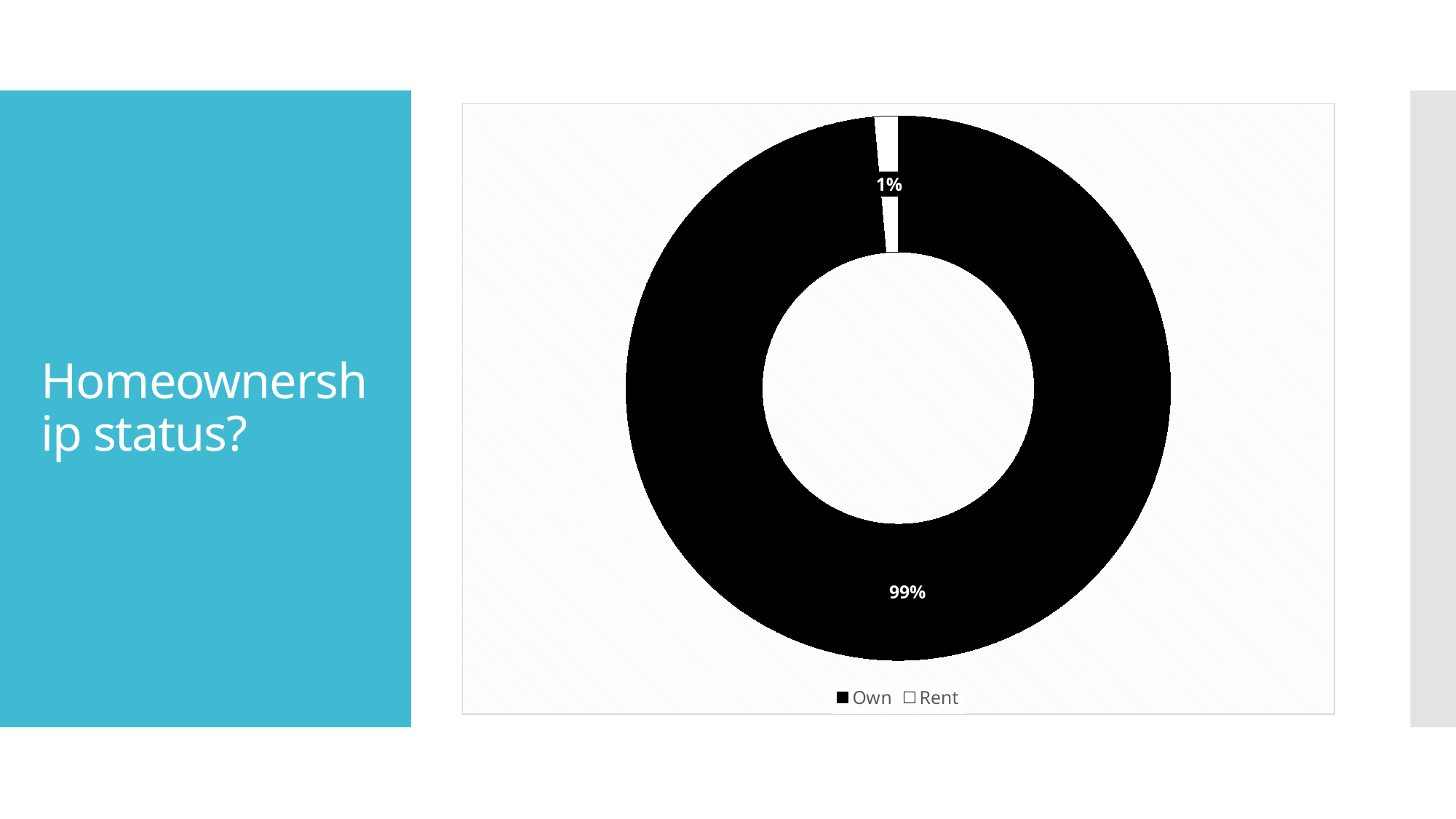
What kind of chart is shown on the slide? Doughnut chart What share of the chart does the Rent slice represent? 1% Which category has the largest slice? Own What colour is the Own slice? Black What is the title text on the slide next to the chart? Homeownership status? What is the difference in percentage points between the Own and Rent slices? 98 What share of the chart does the Own slice represent? 99% Which category has the smallest slice? Rent Which is larger, the Own slice or the Rent slice? Own How many entries does the legend list? 2 How many categories does the chart show? 2